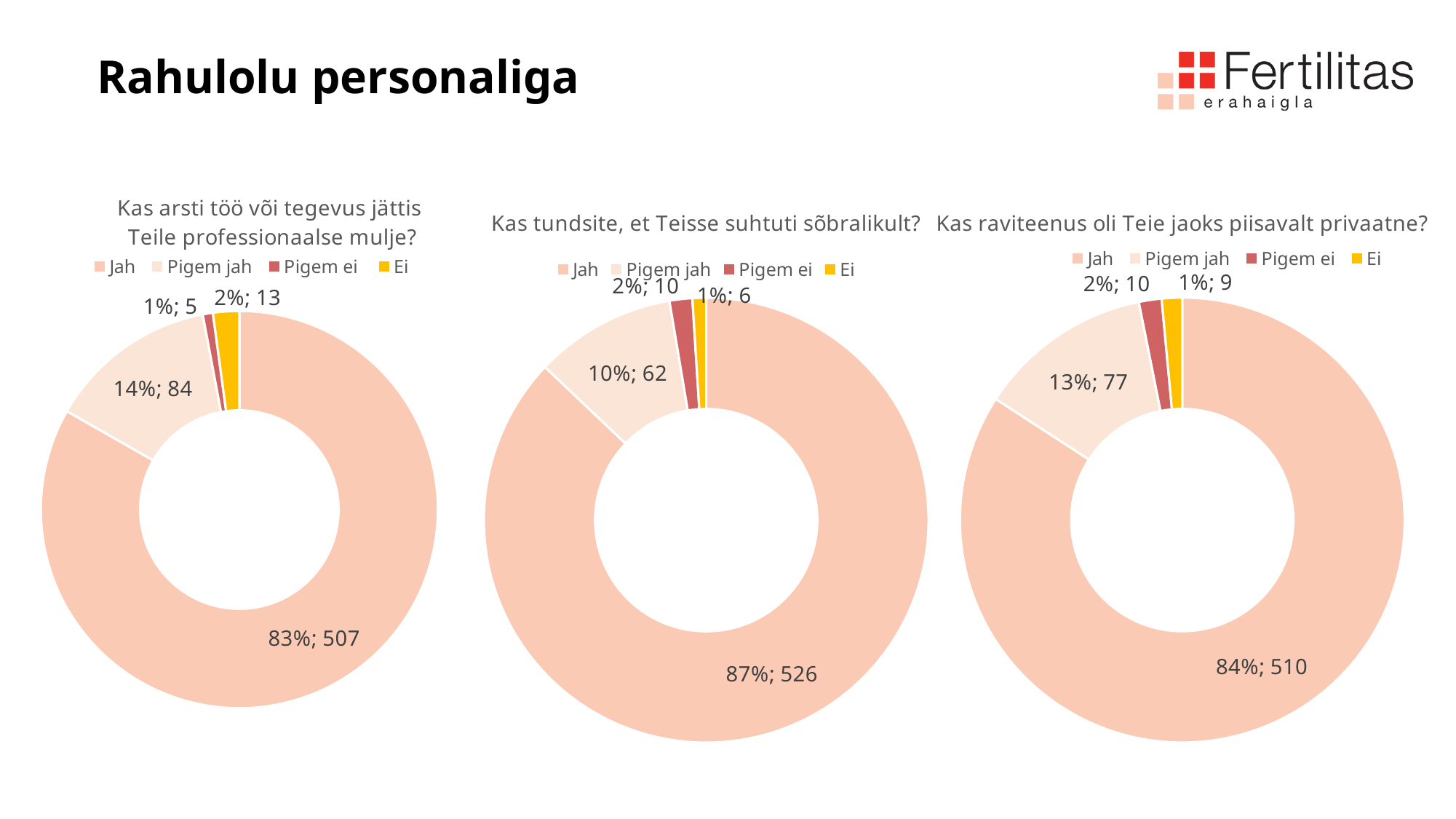
In the chart titled "Kas arsti töö või tegevus jättis Teile professionaalse mulje?", which is larger, the "Ei" slice or the "Pigem ei" slice? Ei In the chart titled "Kas raviteenus oli Teie jaoks piisavalt privaatne?", what is the data label for the "Ei" slice? 1%; 9 In the chart titled "Kas raviteenus oli Teie jaoks piisavalt privaatne?", what share of the pie does the "Pigem jah" slice represent? 13% In the chart titled "Kas arsti töö või tegevus jättis Teile professionaalse mulje?", which category has the smallest slice? Pigem ei What kind of chart is the chart titled "Kas tundsite, et Teisse suhtuti sõbralikult?"? Doughnut chart In the chart titled "Kas tundsite, et Teisse suhtuti sõbralikult?", what is the difference in count between "Jah" and "Pigem jah"? 464 In the chart titled "Kas arsti töö või tegevus jättis Teile professionaalse mulje?", what colour is the "Ei" slice? Yellow In the chart titled "Kas arsti töö või tegevus jättis Teile professionaalse mulje?", what is the data label for the "Jah" slice? 83%; 507 In the chart titled "Kas tundsite, et Teisse suhtuti sõbralikult?", which category has the largest slice? Jah How many charts are shown on the slide? 3 In the chart titled "Kas tundsite, et Teisse suhtuti sõbralikult?", what is the data label for the "Pigem jah" slice? 10%; 62 How many categories does the legend list in the chart titled "Kas raviteenus oli Teie jaoks piisavalt privaatne?"? 4